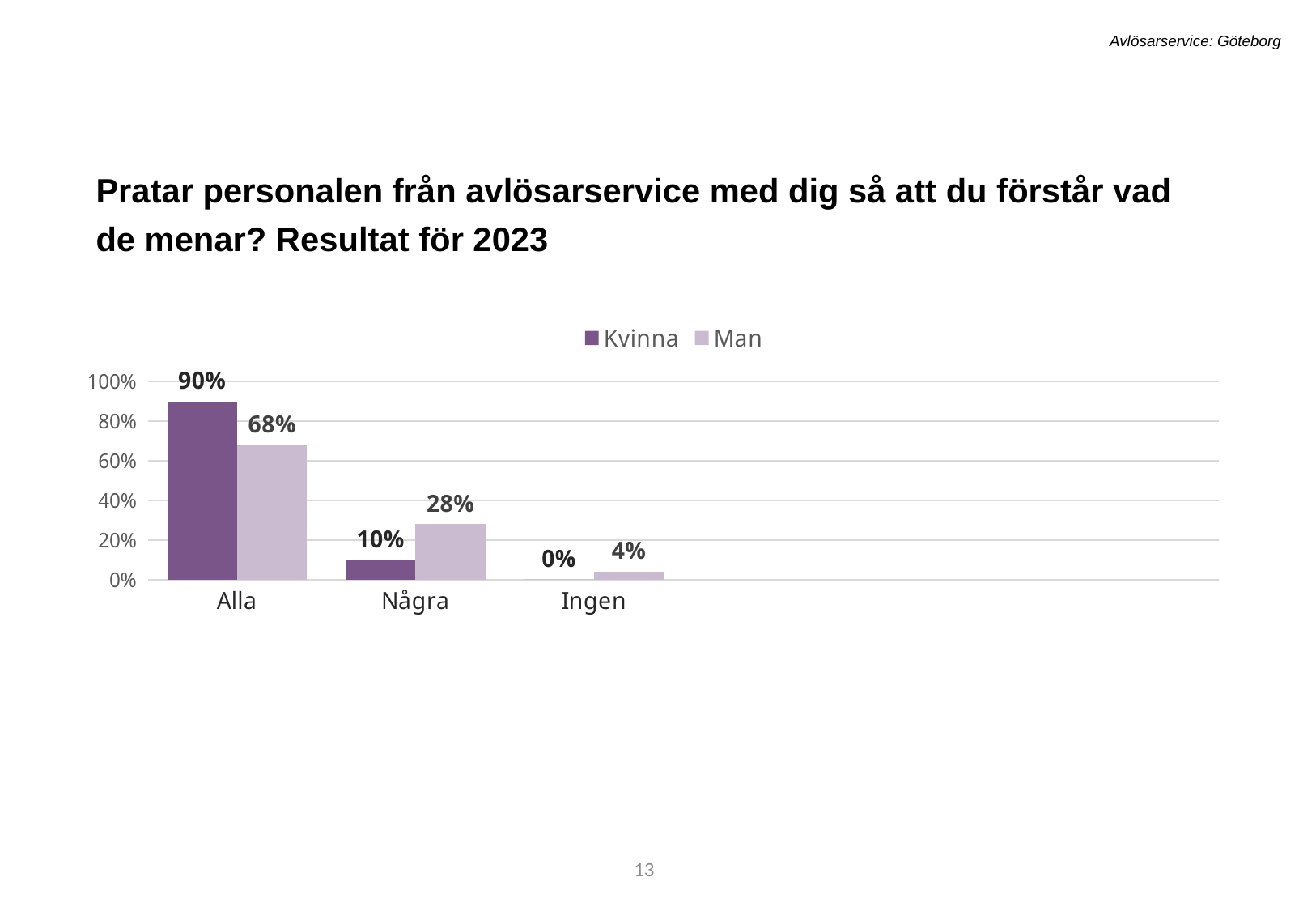
Which category has the highest value for the Man series? Alla What is the value for Man in the Några category? 28% How many categories are shown on the x axis? 3 What kind of chart is shown on the slide? Bar chart What is the value for Man in the Alla category? 68% How many series does the legend list? 2 What is the difference between the Kvinna and Man values in the Alla category? 22% What is the value for Kvinna in the Alla category? 90% In the Några category, which series has the larger value, Kvinna or Man? Man What is the value for Kvinna in the Ingen category? 0% Which series is shown in the darker purple colour? Kvinna Which category has the lowest value for the Kvinna series? Ingen